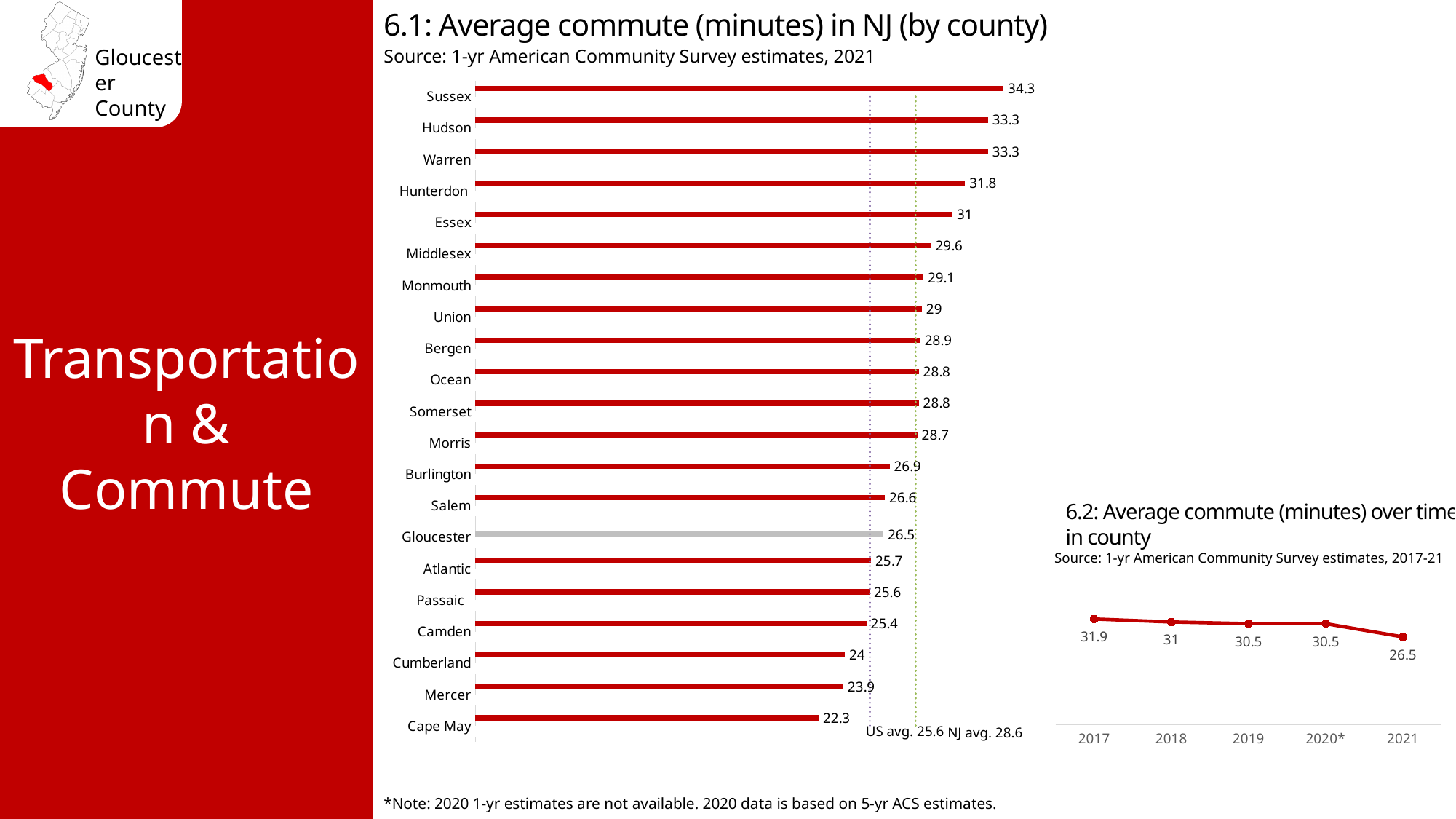
What kind of chart is '6.2: Average commute (minutes) over time in county'? Line chart What kind of chart is '6.1: Average commute (minutes) in NJ (by county)'? Bar chart In the chart '6.1: Average commute (minutes) in NJ (by county)', which is larger, the value for Essex or the value for Middlesex? Essex In the chart '6.2: Average commute (minutes) over time in county', what is the value for 2017? 31.9 In the chart '6.1: Average commute (minutes) in NJ (by county)', what is the value for Gloucester? 26.5 In the chart '6.1: Average commute (minutes) in NJ (by county)', which county has the lowest average commute? Cape May In the chart '6.1: Average commute (minutes) in NJ (by county)', which county has the highest average commute? Sussex In the chart '6.1: Average commute (minutes) in NJ (by county)', what is the value for Hunterdon? 31.8 In the chart '6.2: Average commute (minutes) over time in county', what is the difference between the values for 2017 and 2021? 5.4 In the chart '6.2: Average commute (minutes) over time in county', do the values rise or fall from 2017 to 2021? Fall In the chart '6.1: Average commute (minutes) in NJ (by county)', how many counties are plotted? 21 In the chart '6.1: Average commute (minutes) in NJ (by county)', what is the difference between the values for Sussex and Cape May? 12